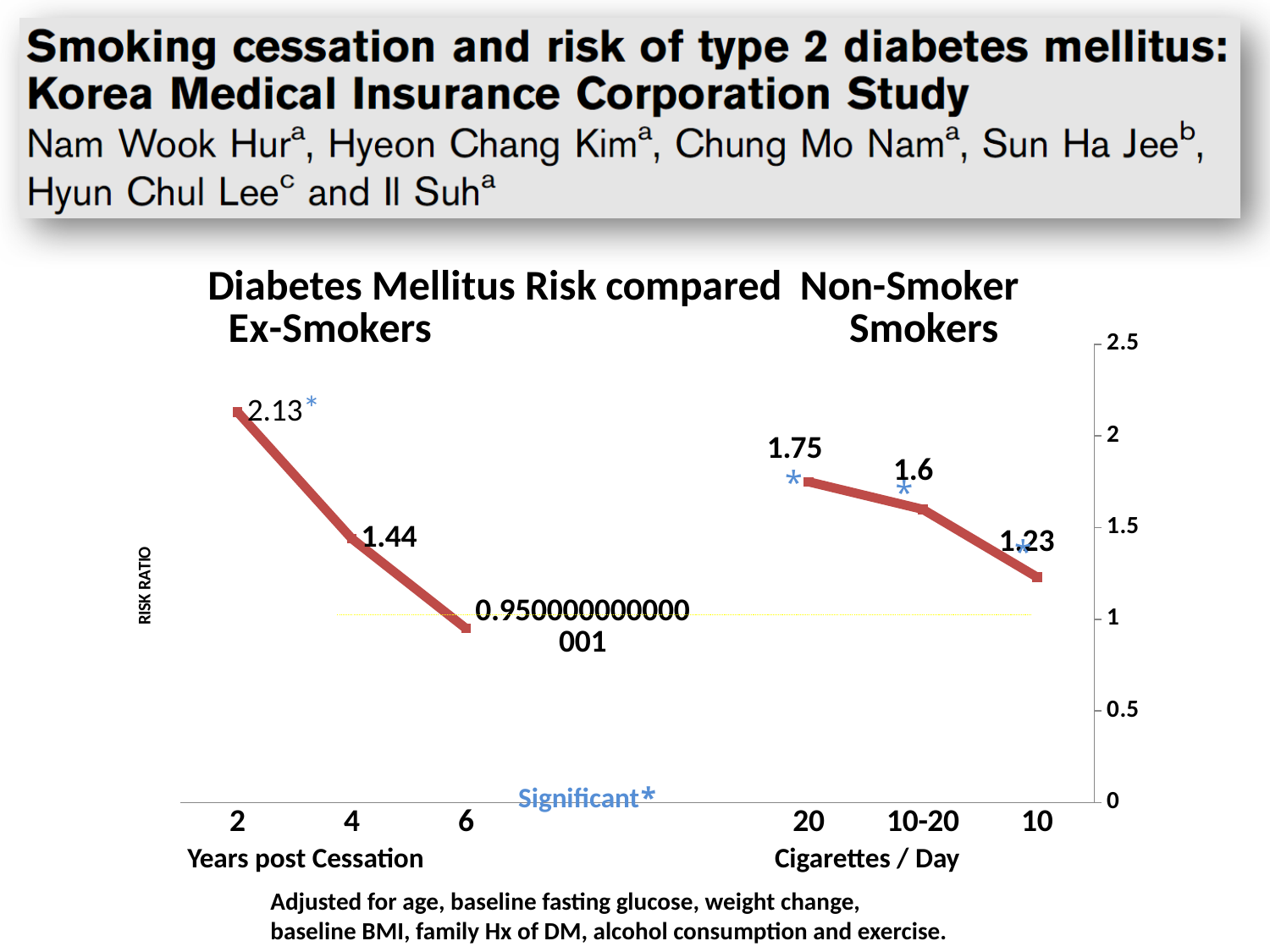
What is the risk ratio for ex-smokers at 2 years post cessation? 2.13 What is the difference in risk ratio between ex-smokers at 2 years and at 4 years post cessation? 0.69 What kind of chart is shown on the slide? Line chart Which plotted point has the highest risk ratio on the chart? Ex-smokers at 2 years post cessation (2.13) Which is larger: the risk ratio for smokers at 20 cigarettes per day or for ex-smokers at 4 years post cessation? Smokers at 20 cigarettes per day What is the risk ratio for smokers at 10 cigarettes per day? 1.23 What is the risk ratio for smokers at 10-20 cigarettes per day? 1.6 Which smoker category has the lowest risk ratio? 10 cigarettes / day How do the risk ratios for ex-smokers change as years post cessation increase from 2 to 6? They fall What is the risk ratio for ex-smokers at 4 years post cessation? 1.44 Is the risk ratio for ex-smokers at 6 years post cessation greater or less than 1? less What is the risk ratio for smokers at 20 cigarettes per day? 1.75